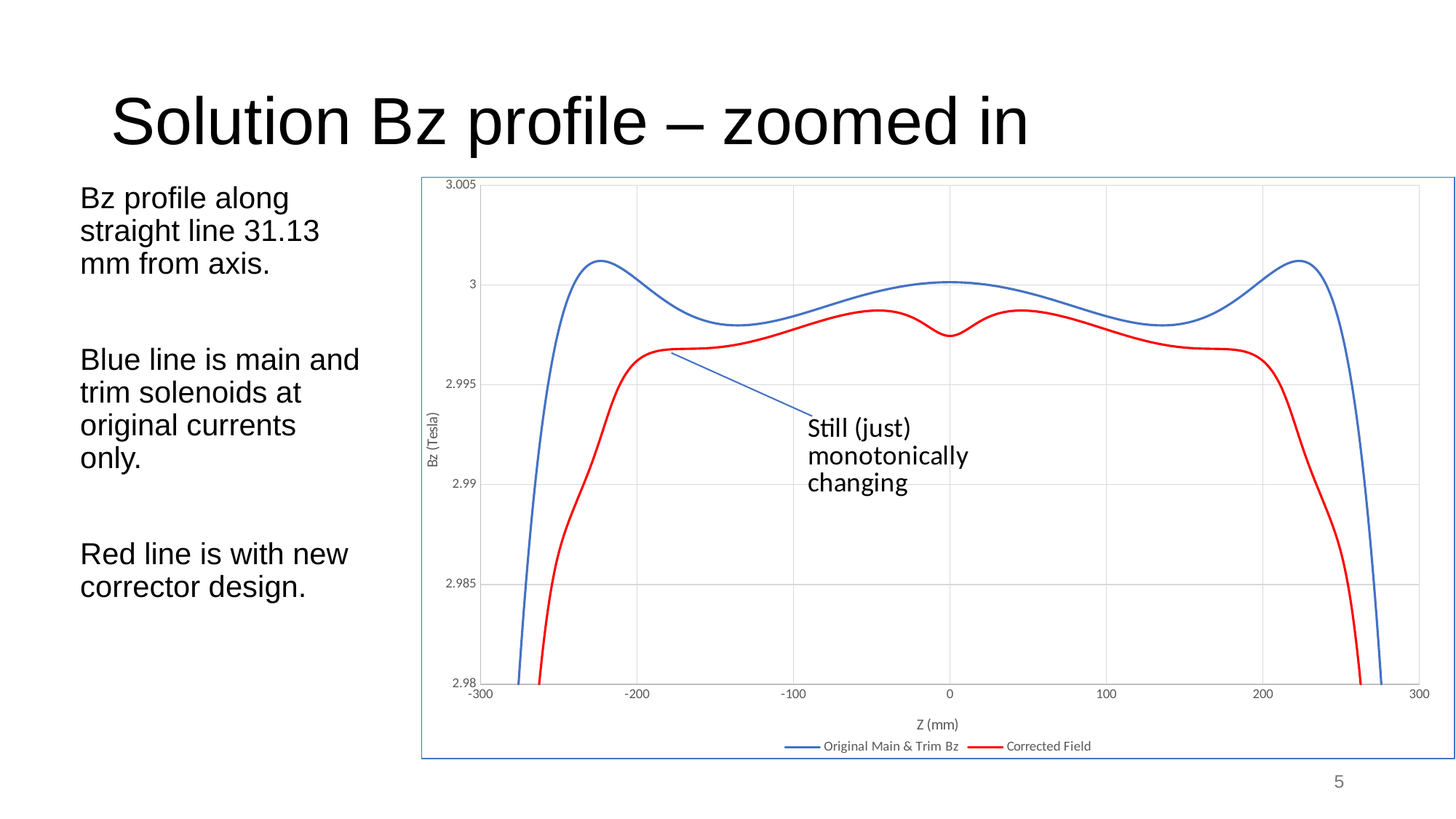
What is the label of the horizontal axis of the chart? Z (mm) How many series does the chart legend list? 2 What kind of chart is shown on the slide? Line chart What are the two series named in the chart legend? Original Main & Trim Bz and Corrected Field What is the lowest value shown on the vertical axis of the chart? 2.98 Is the value of the Corrected Field line at Z = 0 greater or less than 3? less What colour is the Corrected Field line in the chart? Red Is the peak value of the Original Main & Trim Bz line near Z = -225 greater or less than 3? greater What is the highest value shown on the vertical axis of the chart? 3.005 At Z = 0, which series has the higher Bz value, Original Main & Trim Bz or Corrected Field? Original Main & Trim Bz Does the Corrected Field line rise or fall as Z goes from -200 to -50? Rise What is the label of the vertical axis of the chart? Bz (Tesla)